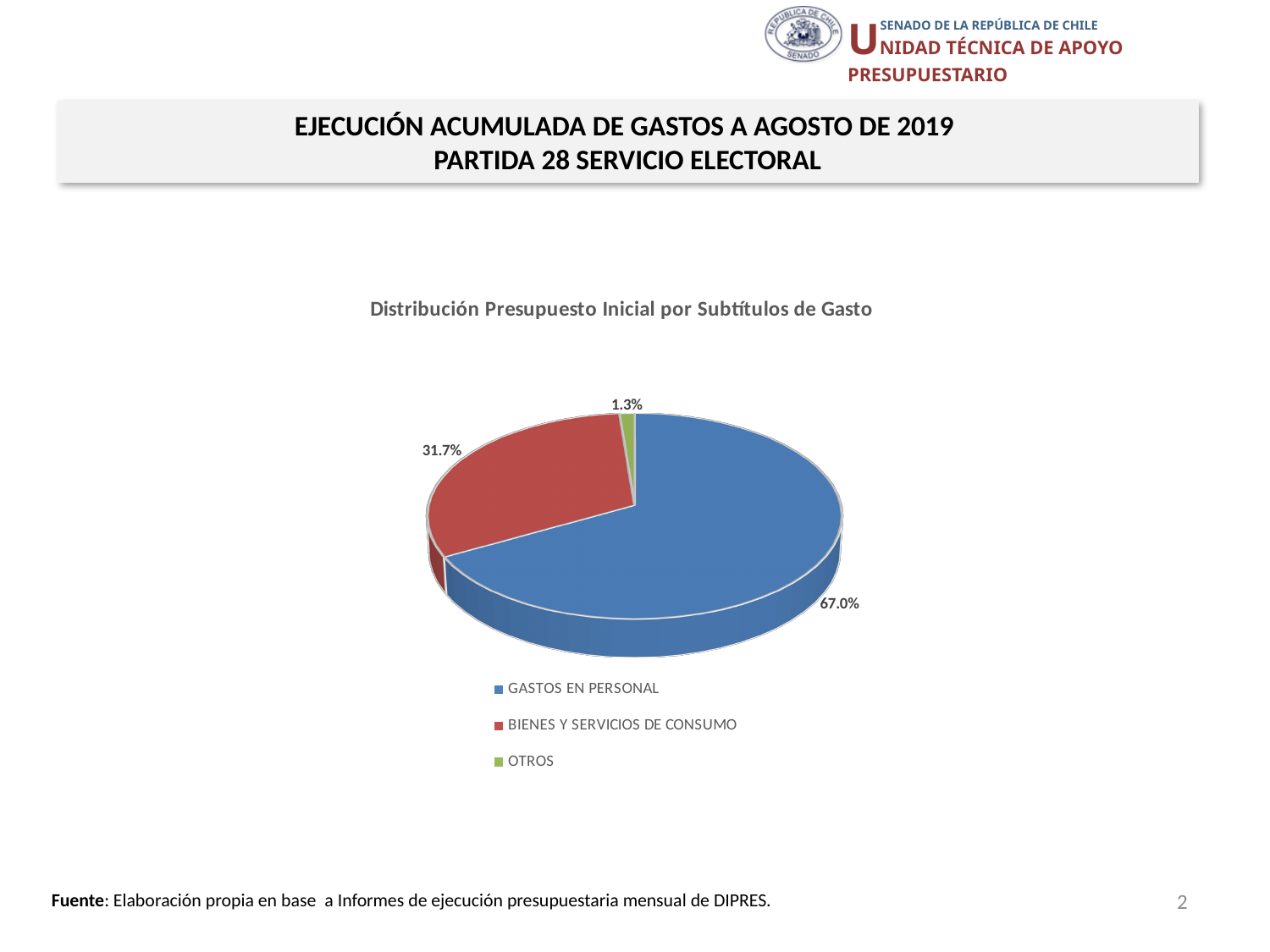
What share of the pie does OTROS represent? 1.3% What kind of chart is shown on the slide? Pie chart What is the title of the chart? Distribución Presupuesto Inicial por Subtítulos de Gasto Which category has the smallest slice of the pie? OTROS What share of the pie does BIENES Y SERVICIOS DE CONSUMO represent? 31.7% What share of the pie does GASTOS EN PERSONAL represent? 67.0% How many categories are shown in the pie chart? 3 Which is larger, the share for BIENES Y SERVICIOS DE CONSUMO or the share for OTROS? BIENES Y SERVICIOS DE CONSUMO What is the difference in percentage points between GASTOS EN PERSONAL and BIENES Y SERVICIOS DE CONSUMO? 35.3 Which category has the largest slice of the pie? GASTOS EN PERSONAL What is the combined share of BIENES Y SERVICIOS DE CONSUMO and OTROS? 33.0% What colour is the slice for BIENES Y SERVICIOS DE CONSUMO? Red